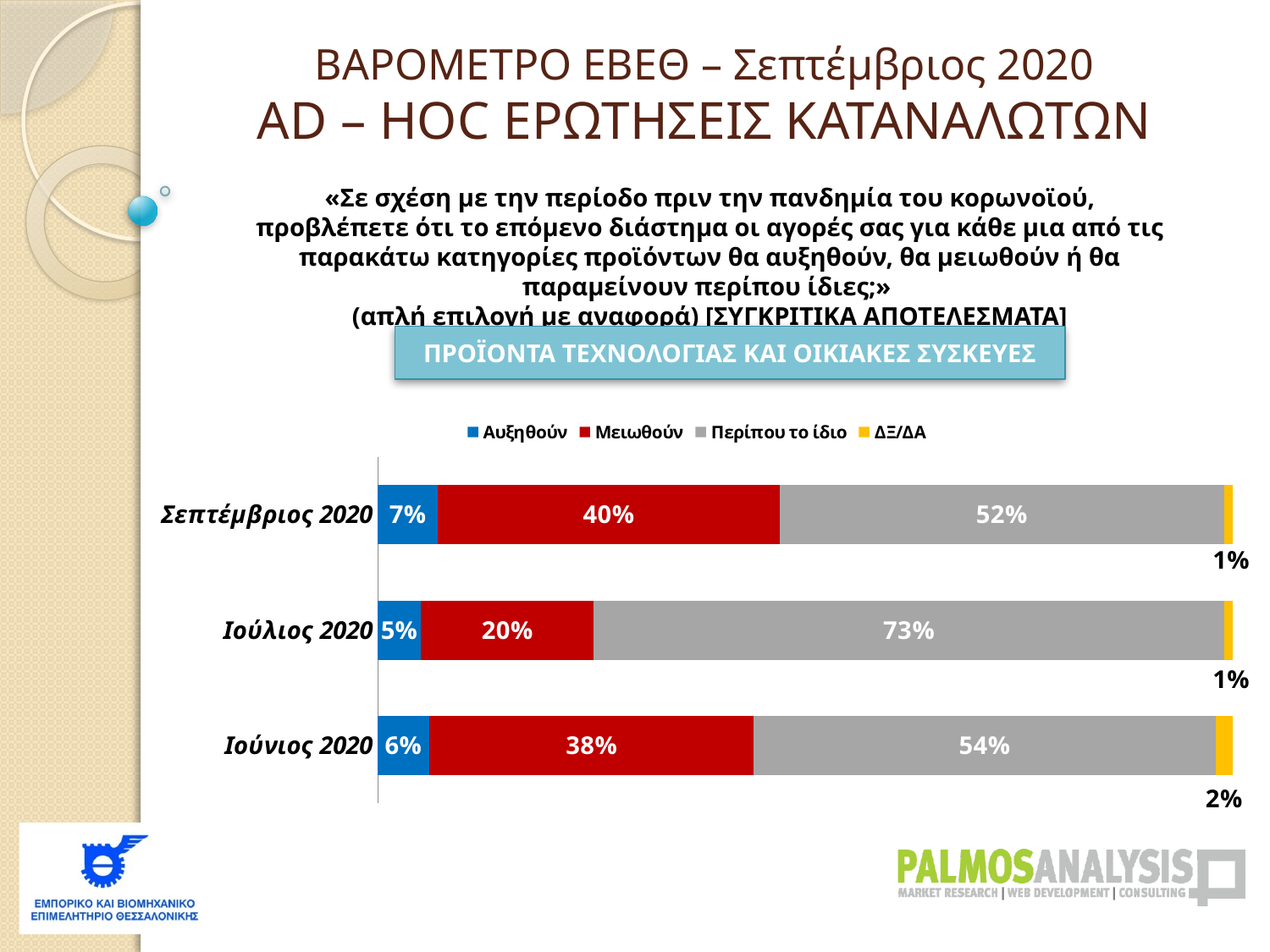
How many categories (periods) are shown on the chart? 3 What is the value for Μειωθούν in Σεπτέμβριος 2020? 40% How many series does the legend list? 4 What type of chart is shown on the slide? Stacked bar chart Which period has the lowest value for Μειωθούν? Ιούλιος 2020 What is the value for Περίπου το ίδιο in Ιούλιος 2020? 73% What is the value for Αυξηθούν in Ιούνιος 2020? 6% Which is larger: the Αυξηθούν value for Σεπτέμβριος 2020 or for Ιούλιος 2020? Σεπτέμβριος 2020 Which period has the highest value for Περίπου το ίδιο? Ιούλιος 2020 Which colour represents the Μειωθούν series in the chart? Red What is the value for ΔΞ/ΔΑ in Ιούνιος 2020? 2% What is the difference between the Μειωθούν values for Σεπτέμβριος 2020 and Ιούλιος 2020? 20 percentage points